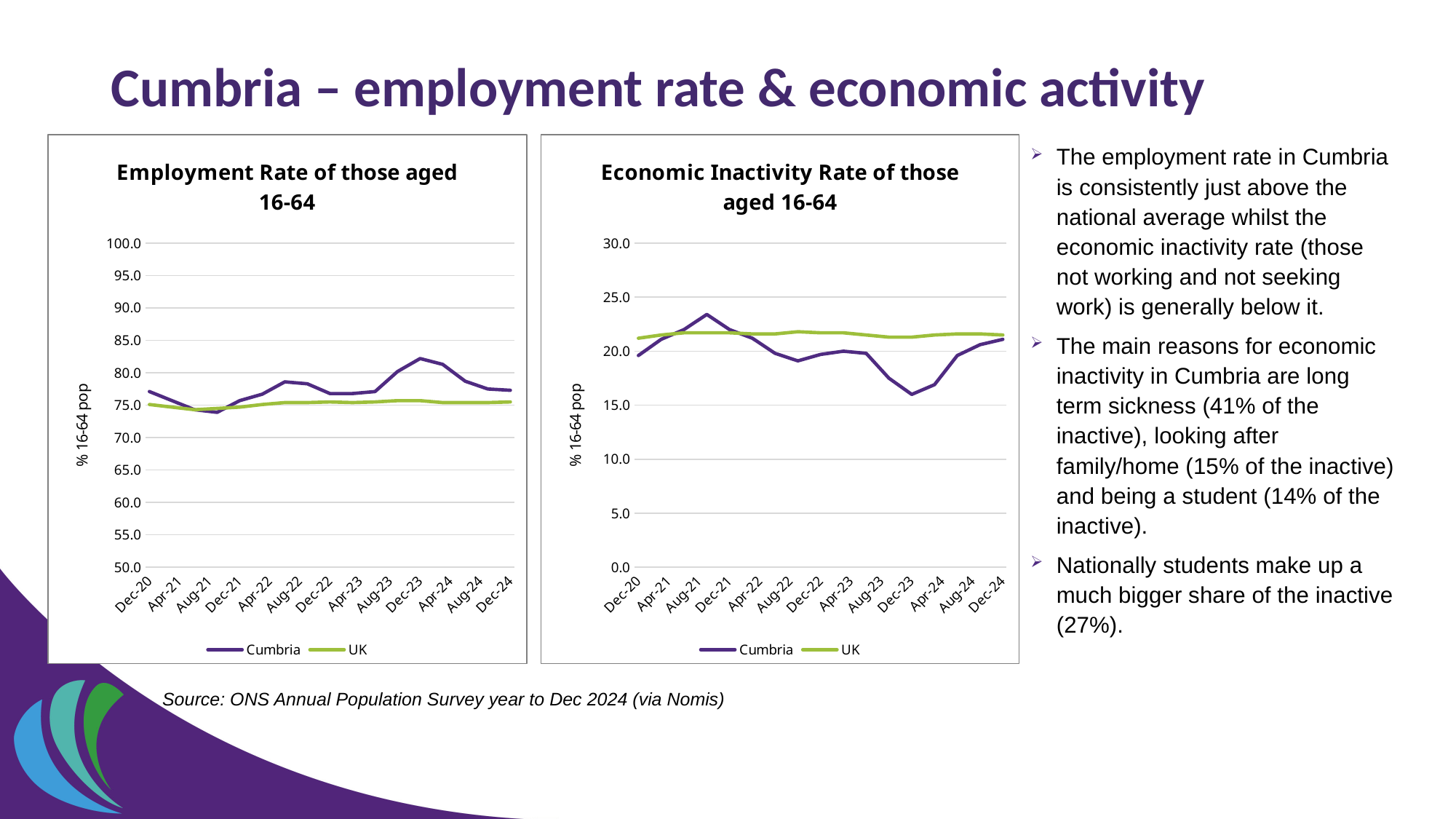
In the 'Employment Rate of those aged 16-64' chart, is the Cumbria value at Dec-23 greater or less than 80.0? greater In the 'Economic Inactivity Rate of those aged 16-64' chart, at which date does the Cumbria line reach its lowest point? Dec-23 In the 'Employment Rate of those aged 16-64' chart, at which date does the Cumbria line reach its highest point? Dec-23 In the 'Employment Rate of those aged 16-64' chart, which series has the higher value at Dec-23, Cumbria or UK? Cumbria What is the y-axis label of the 'Economic Inactivity Rate of those aged 16-64' chart? % 16-64 pop How many series does the legend of the 'Economic Inactivity Rate of those aged 16-64' chart list? 2 In the 'Economic Inactivity Rate of those aged 16-64' chart, is the Cumbria value at Dec-23 greater or less than 20.0? less In the 'Employment Rate of those aged 16-64' chart, how many dates are labelled on the x axis? 13 In the 'Employment Rate of those aged 16-64' chart, is the UK value at Dec-24 greater or less than 80.0? less In the 'Economic Inactivity Rate of those aged 16-64' chart, which series has the higher value at Dec-23, Cumbria or UK? UK What kind of chart is the 'Employment Rate of those aged 16-64' chart? line chart